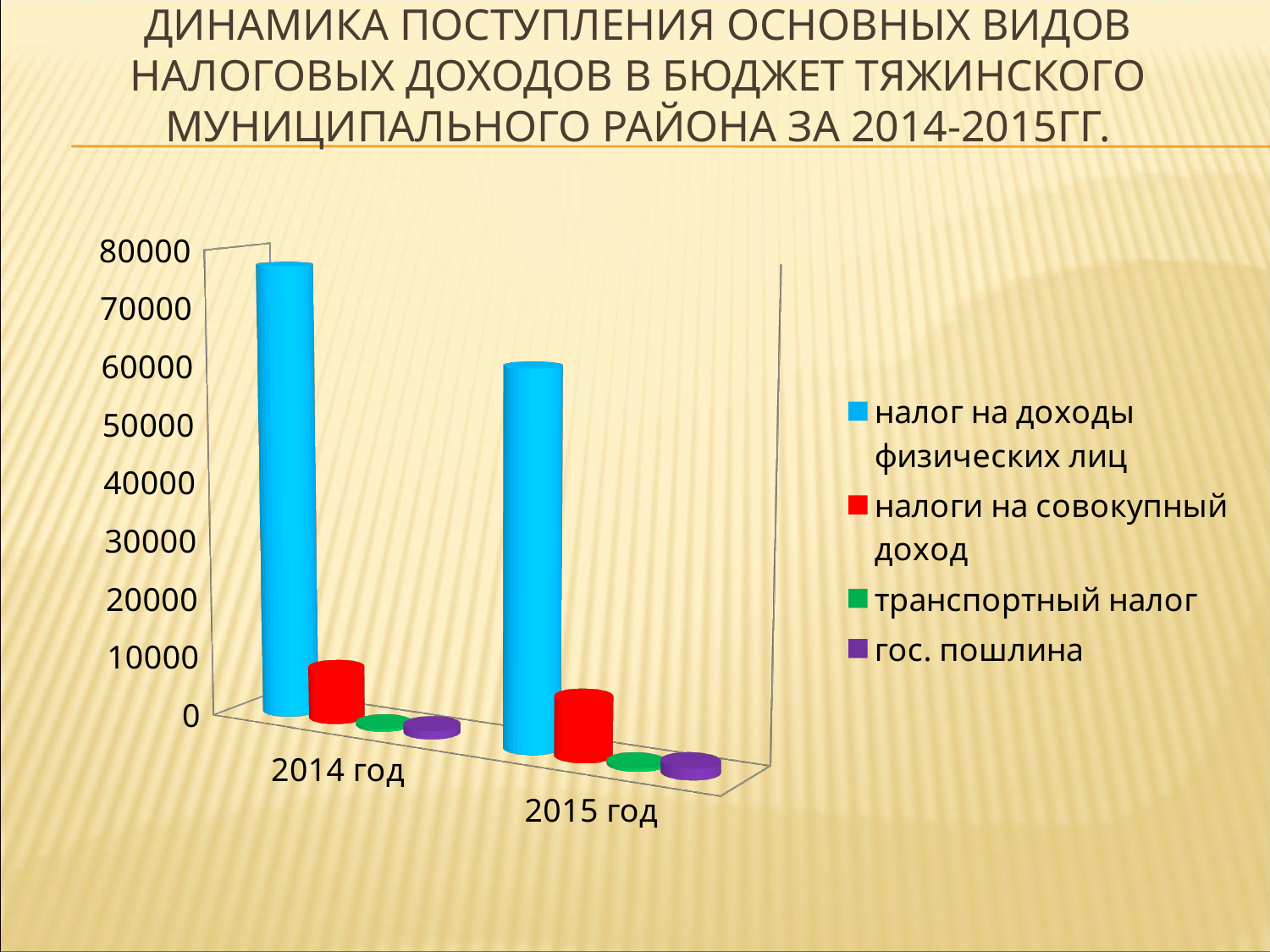
Which is larger: налог на доходы физических лиц in 2014 год or in 2015 год? 2014 год What kind of chart is shown on the slide? bar chart Which is larger in 2015 год: налоги на совокупный доход or транспортный налог? налоги на совокупный доход Is the value of налог на доходы физических лиц for 2015 год greater or less than 50000? greater How many categories (years) are shown on the x axis of the chart? 2 Which series has the highest value in 2014 год? налог на доходы физических лиц What colour represents транспортный налог in the chart legend? green Is the value of налог на доходы физических лиц for 2014 год greater or less than 70000? greater Does the value of налог на доходы физических лиц rise or fall from 2014 год to 2015 год? fall Which series has the highest value in 2015 год? налог на доходы физических лиц How many series does the chart legend list? 4